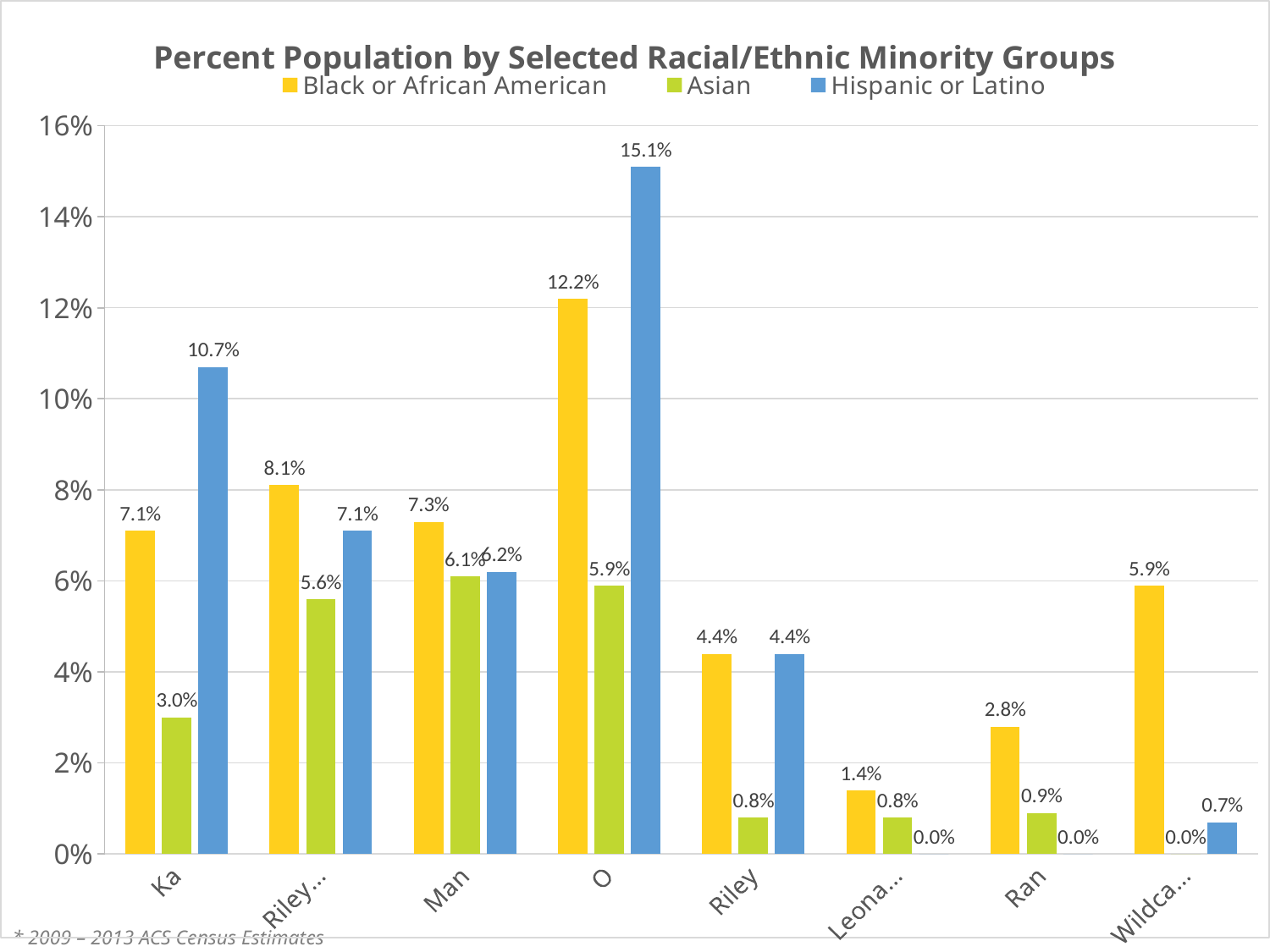
How many categories are shown along the x axis? 8 How many series does the legend list? 3 What is the title of the chart? Percent Population by Selected Racial/Ethnic Minority Groups What is the Hispanic or Latino value for the category labelled "O"? 15.1% For the category labelled "O", how much higher is the Hispanic or Latino value than the Black or African American value? 2.9% Which has the larger Hispanic or Latino value, "Ka" or "Man"? Ka What is the Hispanic or Latino value for the rightmost category (Wildca...)? 0.7% What is the Asian value for the category labelled "Ka"? 3.0% What kind of chart is shown on the slide? bar chart Which category has the highest Black or African American value? O For the category labelled "Ka", what is the difference between the Hispanic or Latino value and the Black or African American value? 3.6% What is the Black or African American value for the category labelled "Ran"? 2.8%